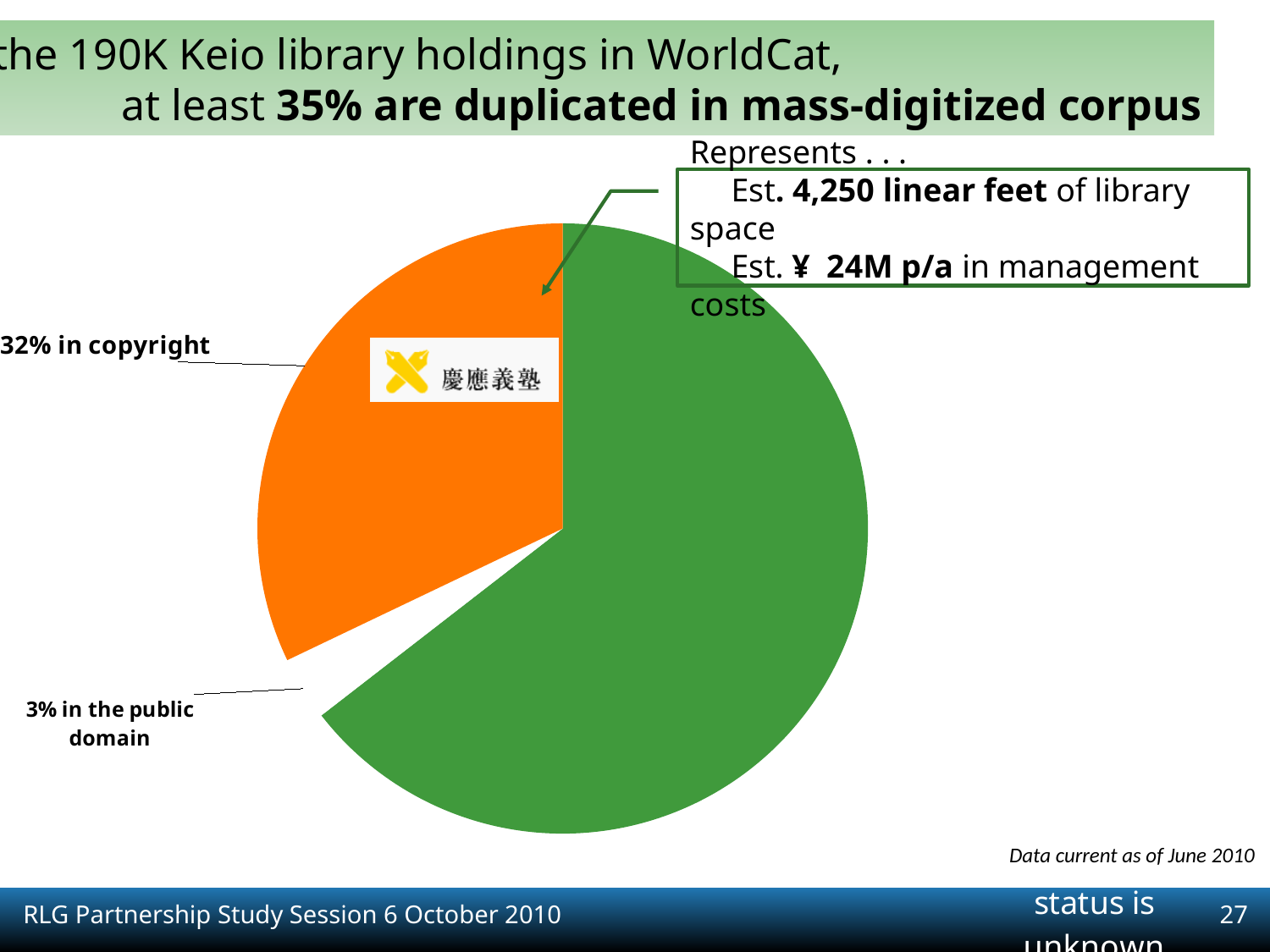
How many linear feet of library space does the annotation estimate the duplicated holdings represent? 4,250 linear feet What is the combined share of the in-copyright and public-domain portions? 35% What share of the Keio library holdings is labelled as in the public domain? 3% What kind of chart is shown on the slide? pie chart Is the green slice of the pie greater or less than 50%? greater Is the orange portion of the pie greater or less than 50%? less Which is larger, the share in copyright or the share in the public domain? in copyright What share of the Keio library holdings is labelled as in copyright? 32% Which colour is the largest slice of the pie? green According to the slide title, at least what percentage of the 190K Keio library holdings are duplicated in the mass-digitized corpus? 35% What is the difference between the share in copyright and the share in the public domain? 29%